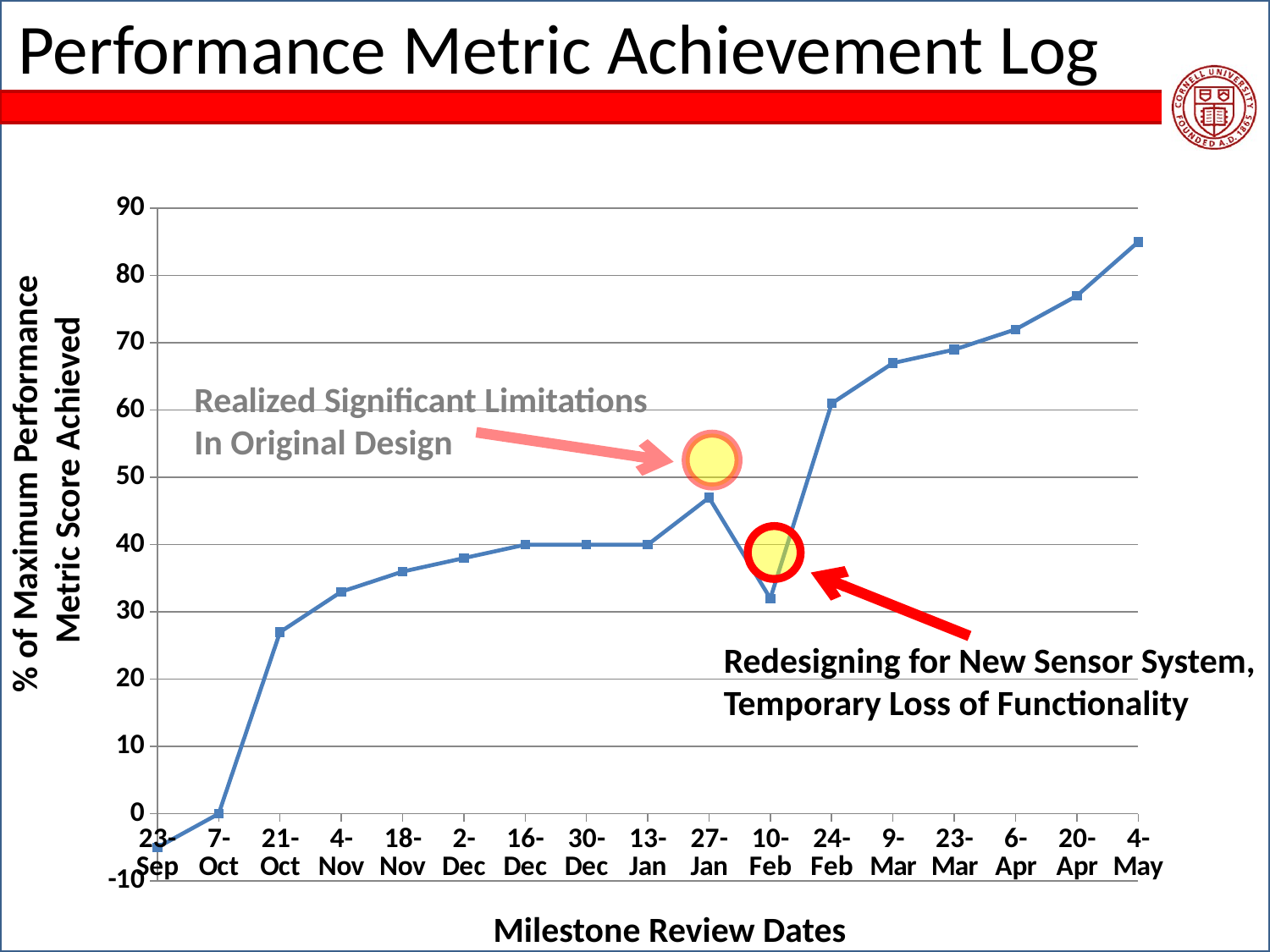
How many milestone review dates are plotted on the x axis? 17 Which is larger, the value for 27-Jan or the value for 10-Feb? 27-Jan What is the value for 7-Oct? 0 What kind of chart is shown on the slide? line chart What is the value for 30-Dec? 40 Is the value for 4-May greater or less than 80? greater Overall, do the values rise or fall from 23-Sep to 4-May? rise Is the value for 10-Feb greater or less than 40? less Which milestone review date has the lowest % of maximum performance metric score achieved? 23-Sep Which milestone review date has the highest % of maximum performance metric score achieved? 4-May What is the title of the x axis? Milestone Review Dates